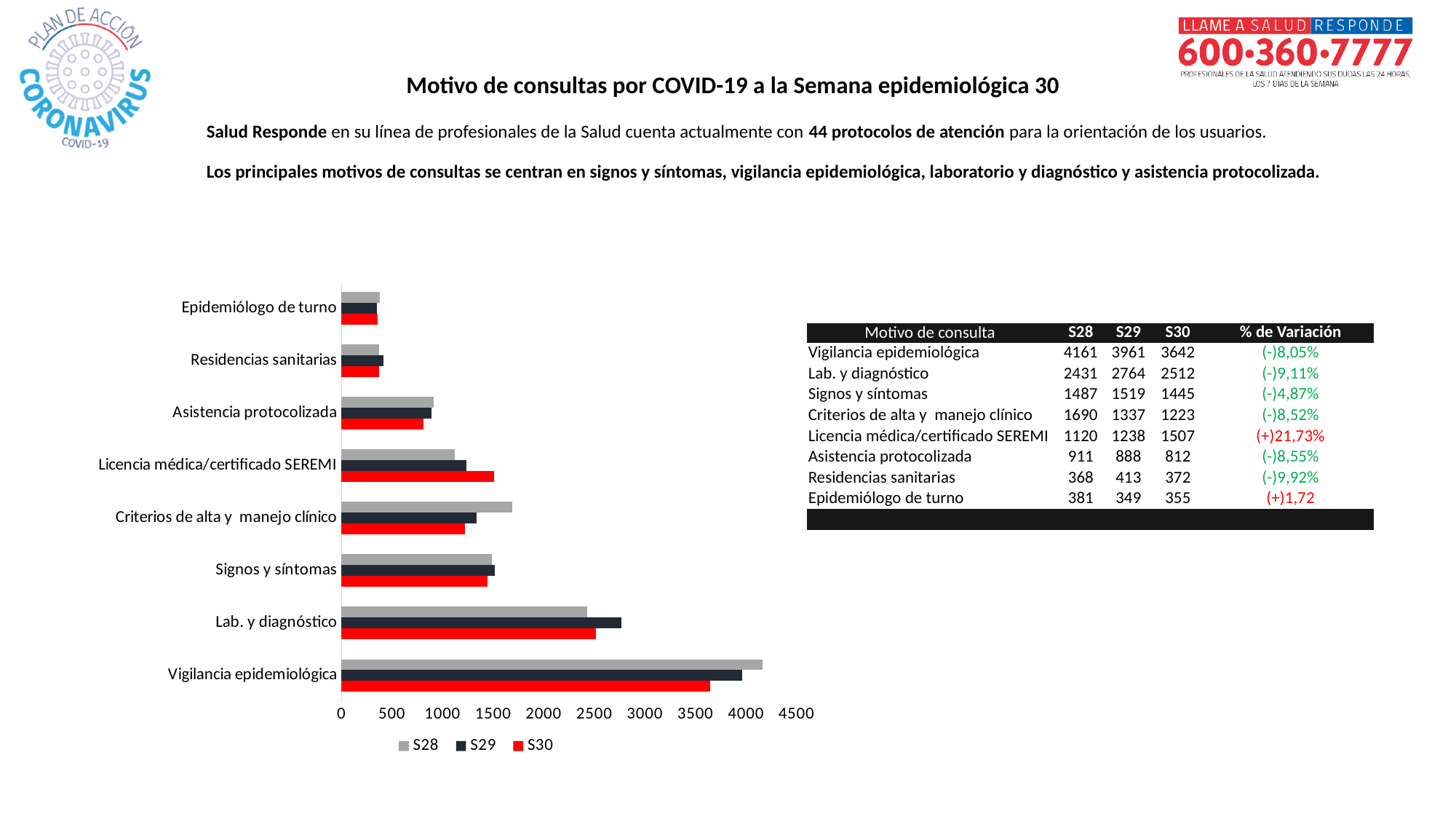
What is the difference between the S28 and S30 values for Vigilancia epidemiológica? 519 How many categories (motivos de consulta) are plotted on the chart? 8 According to the table, which motivo de consulta has the lowest S30 value? Epidemiólogo de turno For Lab. y diagnóstico, which is larger: the S28 value or the S29 value? S29 What kind of chart is shown on the slide? bar chart How many series does the chart legend list? 3 What is the S30 value for Licencia médica/certificado SEREMI? 1507 Is the S28 value for Criterios de alta y manejo clínico greater or less than 1500? greater Is the S30 value for Vigilancia epidemiológica greater or less than 3500? greater Which category has the highest S28 value? Vigilancia epidemiológica What is the S28 value for Lab. y diagnóstico? 2431 What colour represents the S30 series in the chart? red